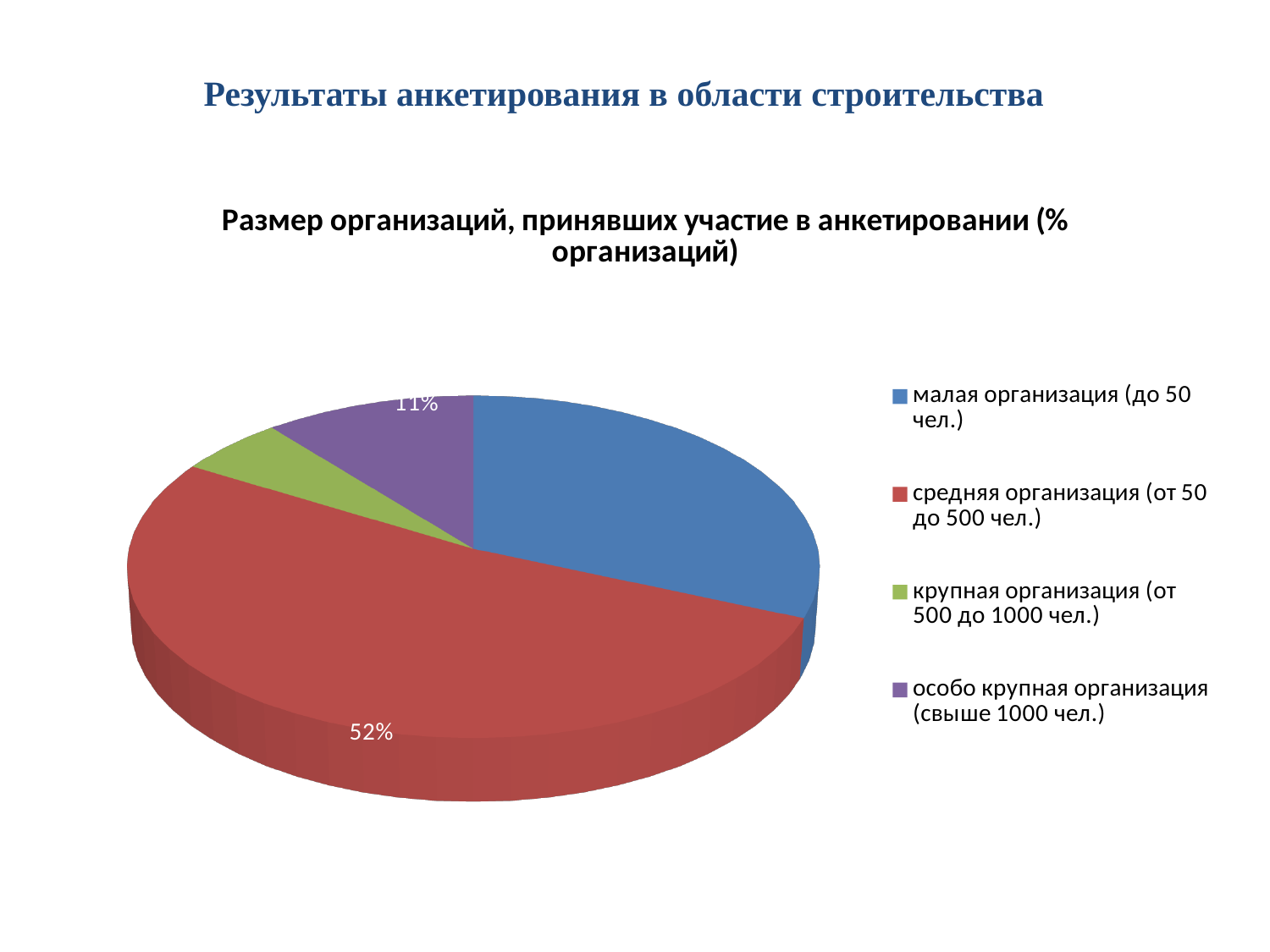
Which is larger: the slice for малая организация or the slice for особо крупная организация? малая организация How many slices does the pie chart have? 4 Which category has the smallest slice of the pie? крупная организация (от 500 до 1000 чел.) Which category has the largest slice of the pie? средняя организация (от 50 до 500 чел.) What share of organisations are средняя организация (от 50 до 500 чел.)? 52% How many entries does the legend list? 4 What kind of chart is shown on the slide? Pie chart What colour is the slice for малая организация (до 50 чел.)? Blue What is the difference in percentage points between the средняя организация slice and the особо крупная организация slice? 41% Which is larger: the slice for средняя организация or the slice for малая организация? средняя организация What is the title of the chart? Размер организаций, принявших участие в анкетировании (% организаций) What share of organisations are особо крупная организация (свыше 1000 чел.)? 11%